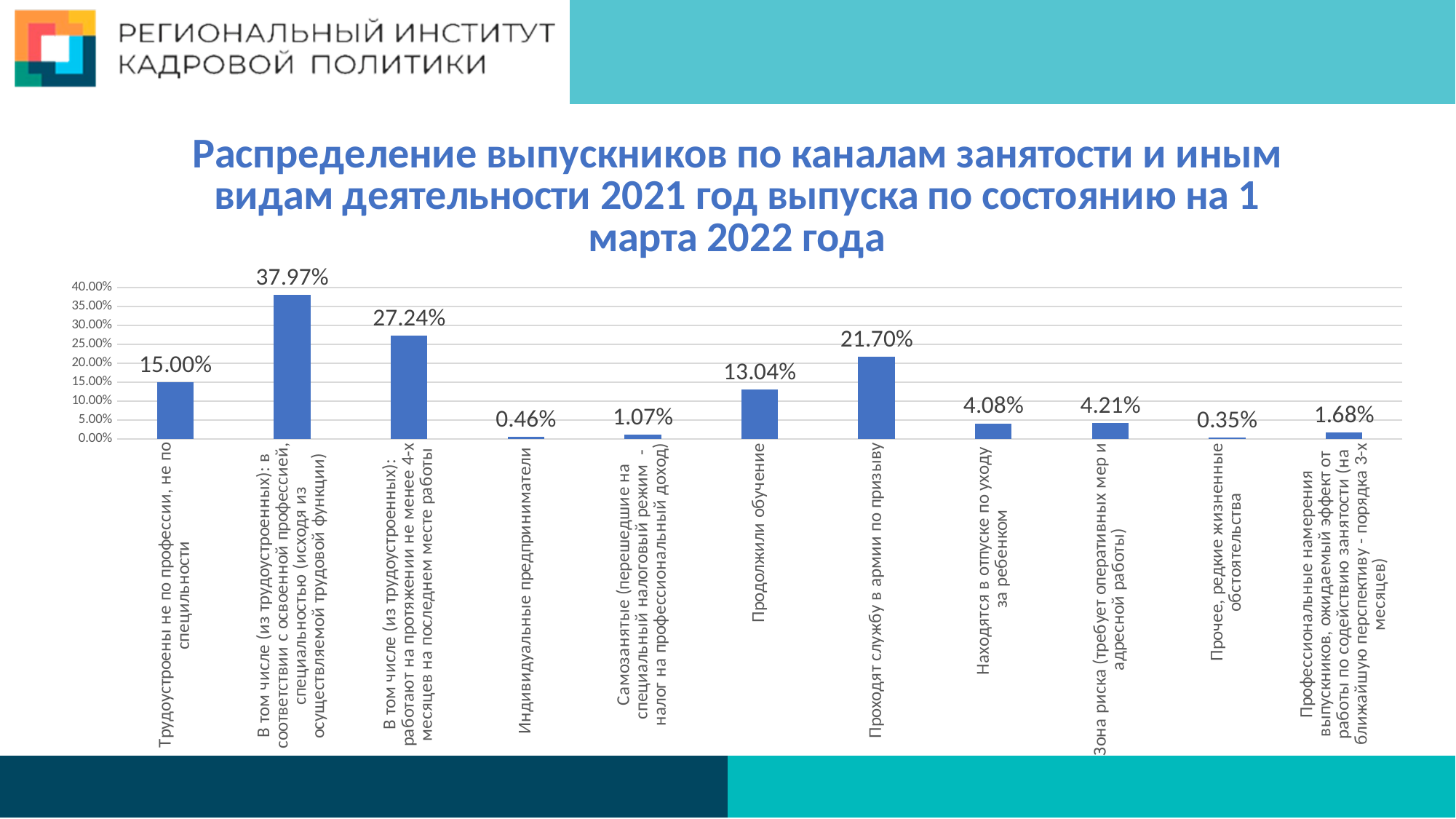
What is the value for "Находятся в отпуске по уходу за ребенком"? 4.08% What type of chart is shown on the slide? Bar chart Which is larger: the value for "Трудоустроены не по профессии, не по специальности" or the value for "Продолжили обучение"? Трудоустроены не по профессии, не по специальности What is the value for "Проходят службу в армии по призыву"? 21.70% Which category has the highest value? В том числе (из трудоустроенных): в соответствии с освоенной профессией, специальностью (исходя из осуществляемой трудовой функции) How many categories are plotted in the chart? 11 Is the value for "Проходят службу в армии по призыву" greater or less than 20.00%? greater What is the title of the chart? Распределение выпускников по каналам занятости и иным видам деятельности 2021 год выпуска по состоянию на 1 марта 2022 года What is the value for "Индивидуальные предприниматели"? 0.46% Which category has the lowest value? Прочее, редкие жизненные обстоятельства What is the difference between the value for "Проходят службу в армии по призыву" and the value for "Продолжили обучение"? 8.66% What is the value for "Продолжили обучение"? 13.04%